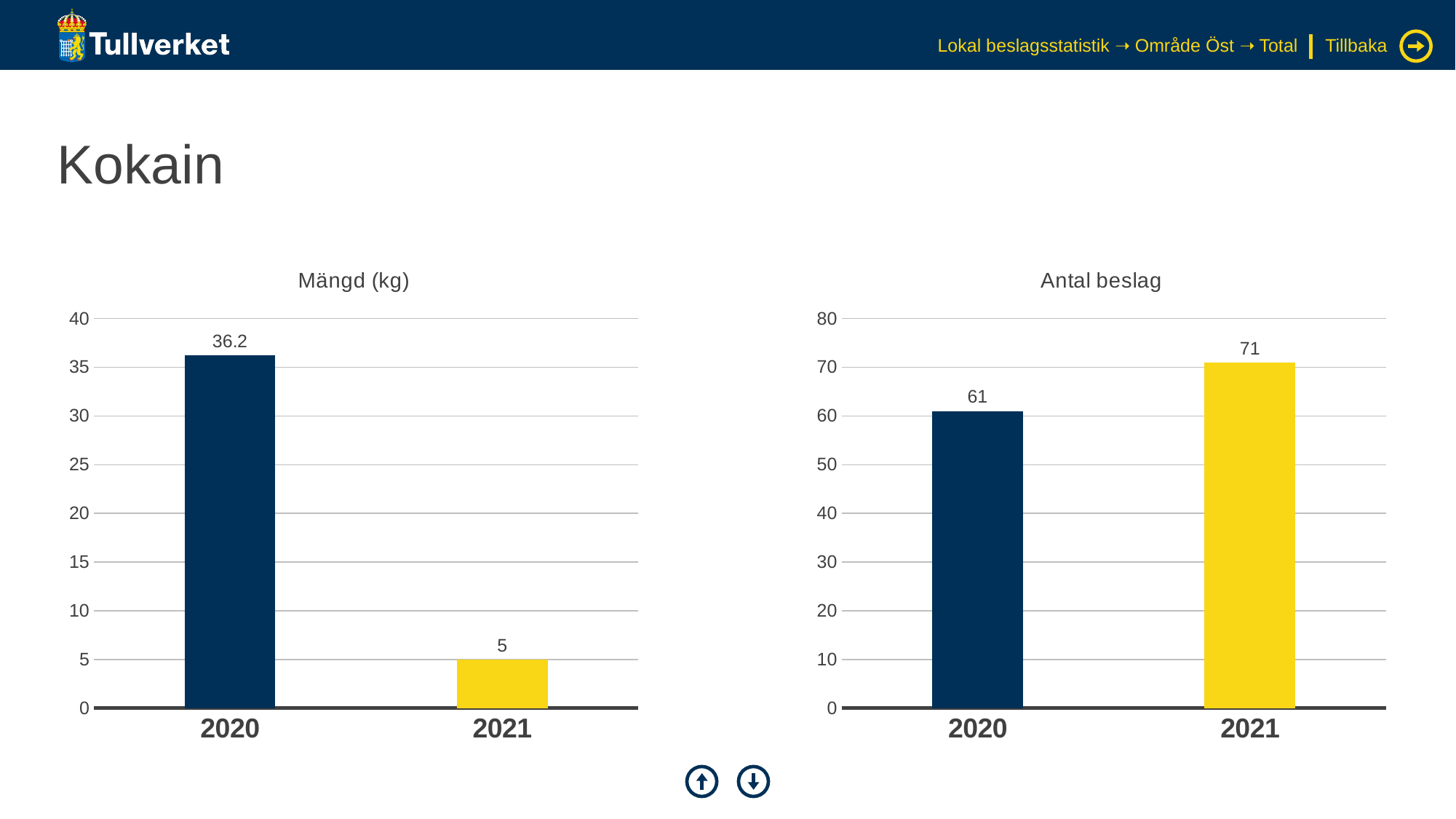
In the 'Antal beslag' chart, which year has the lowest value? 2020 In the 'Antal beslag' chart, is the value for 2021 larger than the value for 2020? Yes In the 'Mängd (kg)' chart, do the values rise or fall from 2020 to 2021? Fall In the 'Mängd (kg)' chart, what is the difference between the 2020 and 2021 values? 31.2 In the 'Antal beslag' chart, what is the value for 2021? 71 In the 'Antal beslag' chart, what is the difference between the 2021 and 2020 values? 10 In the 'Mängd (kg)' chart, what is the value for 2021? 5 In the 'Mängd (kg)' chart, what is the value for 2020? 36.2 How many categories does the 'Antal beslag' chart show? 2 In the 'Mängd (kg)' chart, which year has the highest value? 2020 In the 'Antal beslag' chart, what is the value for 2020? 61 What kind of chart is the 'Mängd (kg)' chart? Bar chart